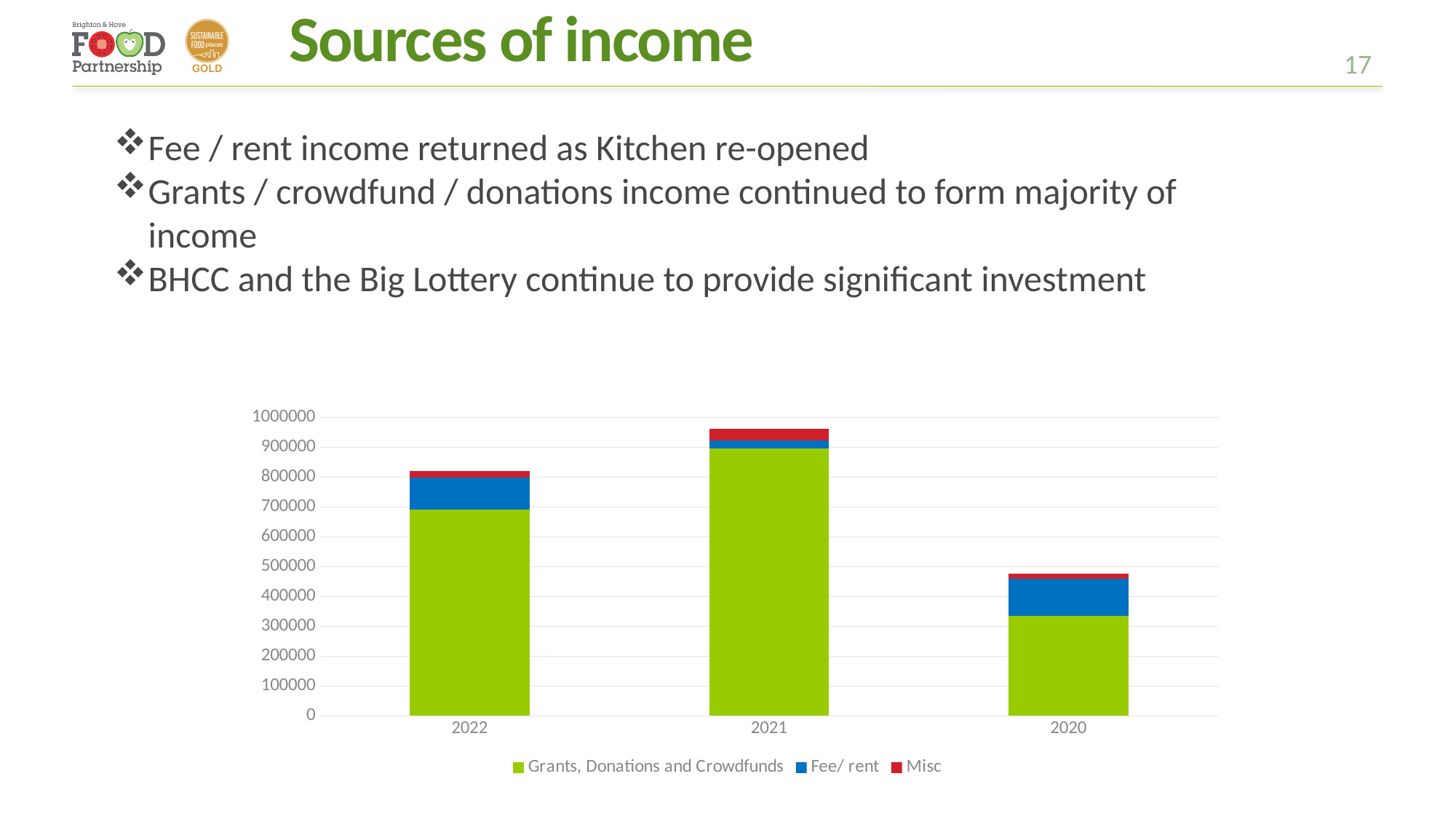
What kind of chart is shown on the slide? Stacked bar chart Is the total income bar for 2020 greater or less than 500000? less Which year has the larger Fee/ rent segment, 2021 or 2020? 2020 Is the total income bar for 2022 greater or less than 800000? greater How many years are shown on the x axis of the chart? 3 Which series is shown in red in the chart? Misc Which series is shown in green in the chart? Grants, Donations and Crowdfunds Which year has the tallest total income bar? 2021 Which year has the shortest total income bar? 2020 Is the Grants, Donations and Crowdfunds value for 2021 greater or less than 800000? greater How many series does the chart's legend list? 3